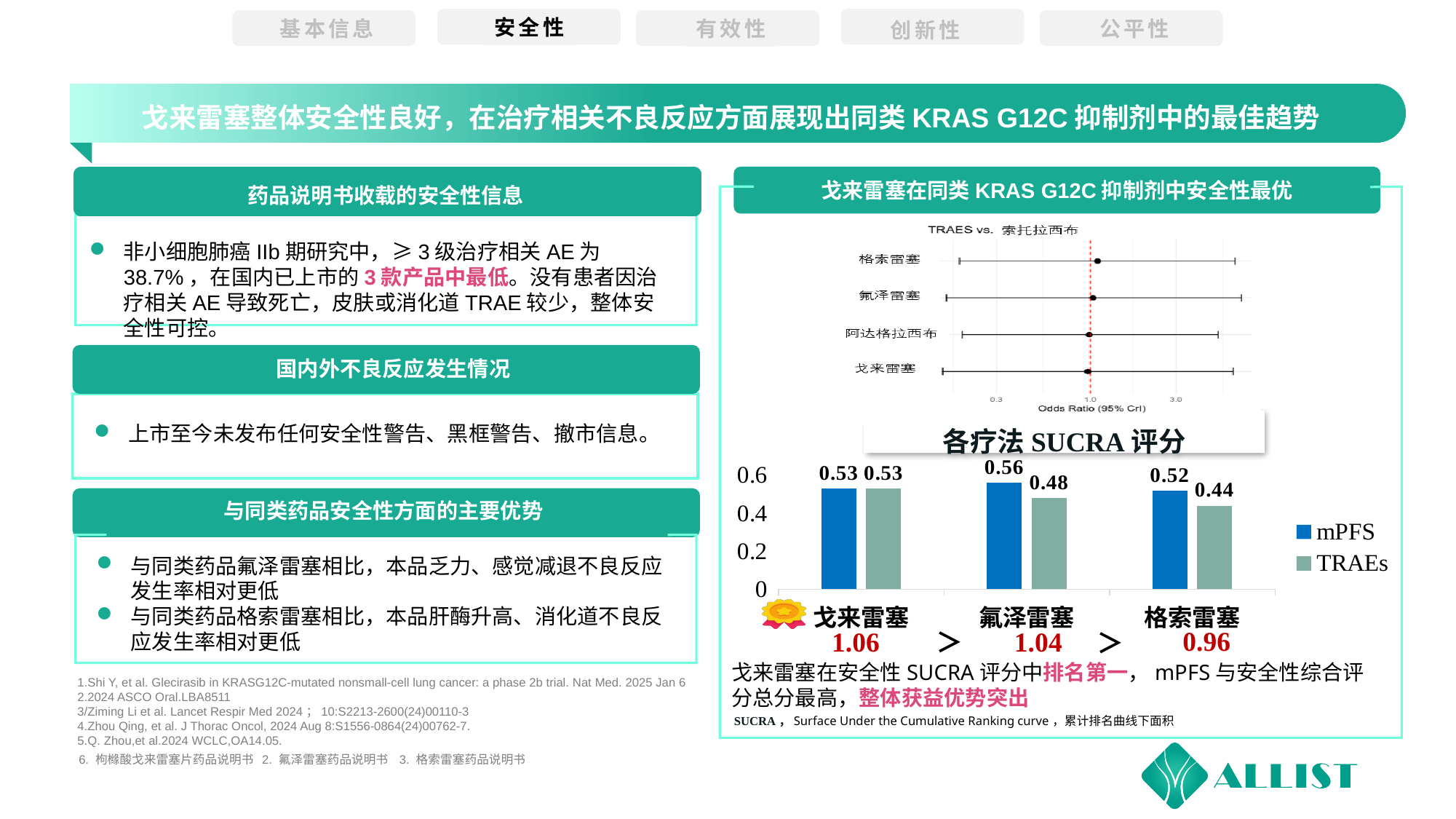
In the 各疗法 SUCRA 评分 chart, which is larger: the TRAEs score for 戈来雷塞 or the TRAEs score for 氟泽雷塞? 戈来雷塞 In the 各疗法 SUCRA 评分 chart, what is the combined mPFS and TRAEs total for 戈来雷塞? 1.06 In the 各疗法 SUCRA 评分 chart, which therapy has the lowest TRAEs score? 格索雷塞 In the 各疗法 SUCRA 评分 chart, which therapy has the highest mPFS score? 氟泽雷塞 In the 各疗法 SUCRA 评分 chart, how many therapies are shown on the x axis? 3 In the TRAEs vs. 索托拉西布 forest plot at the top right, how many drugs are listed on the y axis? 4 In the 各疗法 SUCRA 评分 chart, how many series does the legend list? 2 In the 各疗法 SUCRA 评分 chart, what is the TRAEs value for 戈来雷塞? 0.53 What kind of chart is the 各疗法 SUCRA 评分 chart? bar chart In the 各疗法 SUCRA 评分 chart, what is the difference between the mPFS and TRAEs scores for 氟泽雷塞? 0.08 In the 各疗法 SUCRA 评分 chart, what is the mPFS value for 氟泽雷塞? 0.56 In the 各疗法 SUCRA 评分 chart, what is the TRAEs value for 格索雷塞? 0.44